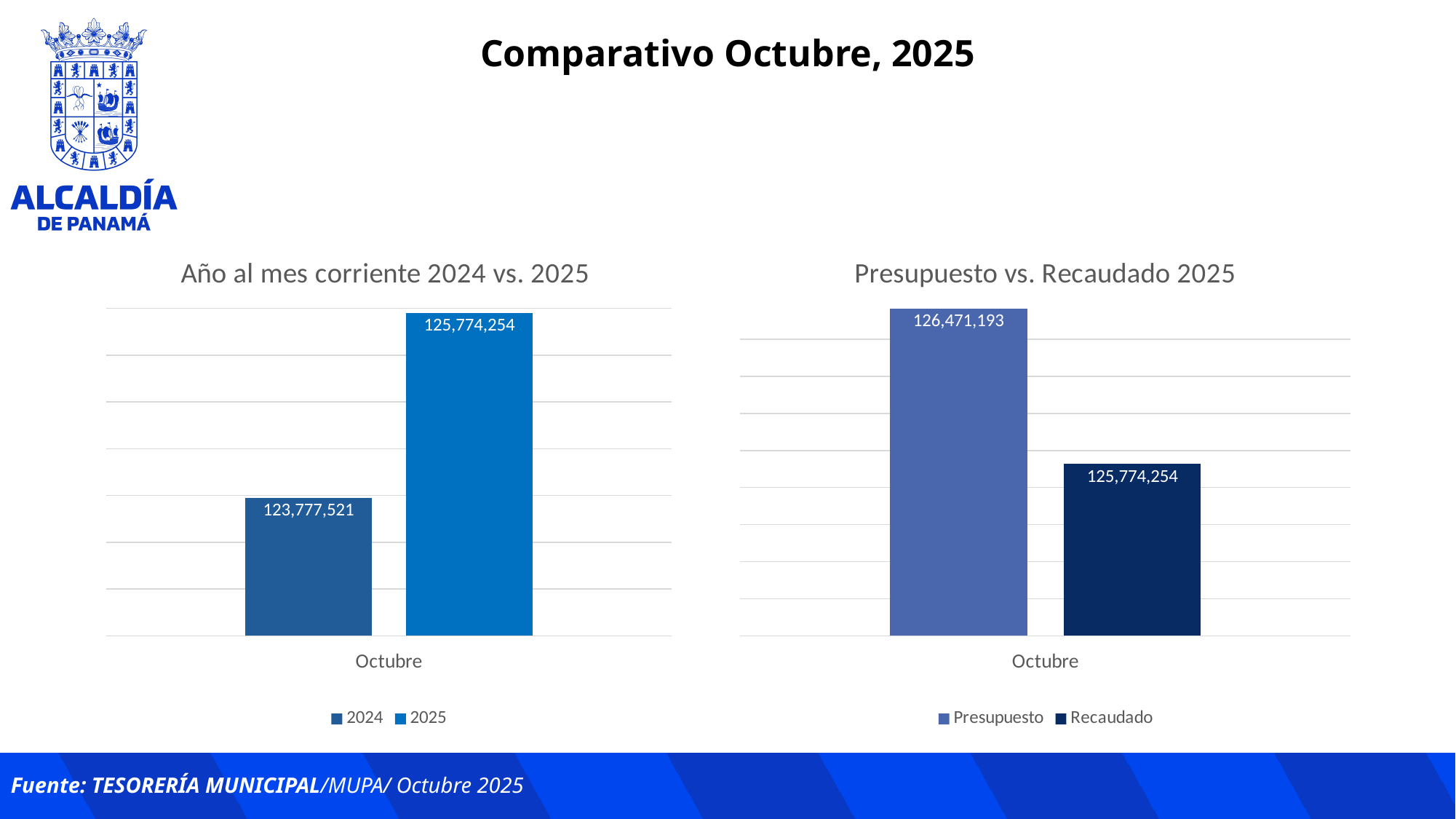
In the chart 'Presupuesto vs. Recaudado 2025', what is the difference between Presupuesto and Recaudado? 696,939 In the chart 'Año al mes corriente 2024 vs. 2025', which series has the higher value? 2025 In the chart 'Presupuesto vs. Recaudado 2025', is Presupuesto or Recaudado larger? Presupuesto What kind of chart is 'Presupuesto vs. Recaudado 2025'? Bar chart In the chart 'Presupuesto vs. Recaudado 2025', what is the value for Recaudado? 125,774,254 In the chart 'Año al mes corriente 2024 vs. 2025', what is the value for 2025 in Octubre? 125,774,254 In the chart 'Año al mes corriente 2024 vs. 2025', what is the difference between the 2025 and 2024 values? 1,996,733 What category label appears on the x axis of the chart 'Año al mes corriente 2024 vs. 2025'? Octubre In the chart 'Presupuesto vs. Recaudado 2025', which series has the lower value? Recaudado How many series does the legend of the chart 'Año al mes corriente 2024 vs. 2025' list? 2 In the chart 'Presupuesto vs. Recaudado 2025', what is the value for Presupuesto? 126,471,193 In the chart 'Año al mes corriente 2024 vs. 2025', what is the value for 2024 in Octubre? 123,777,521